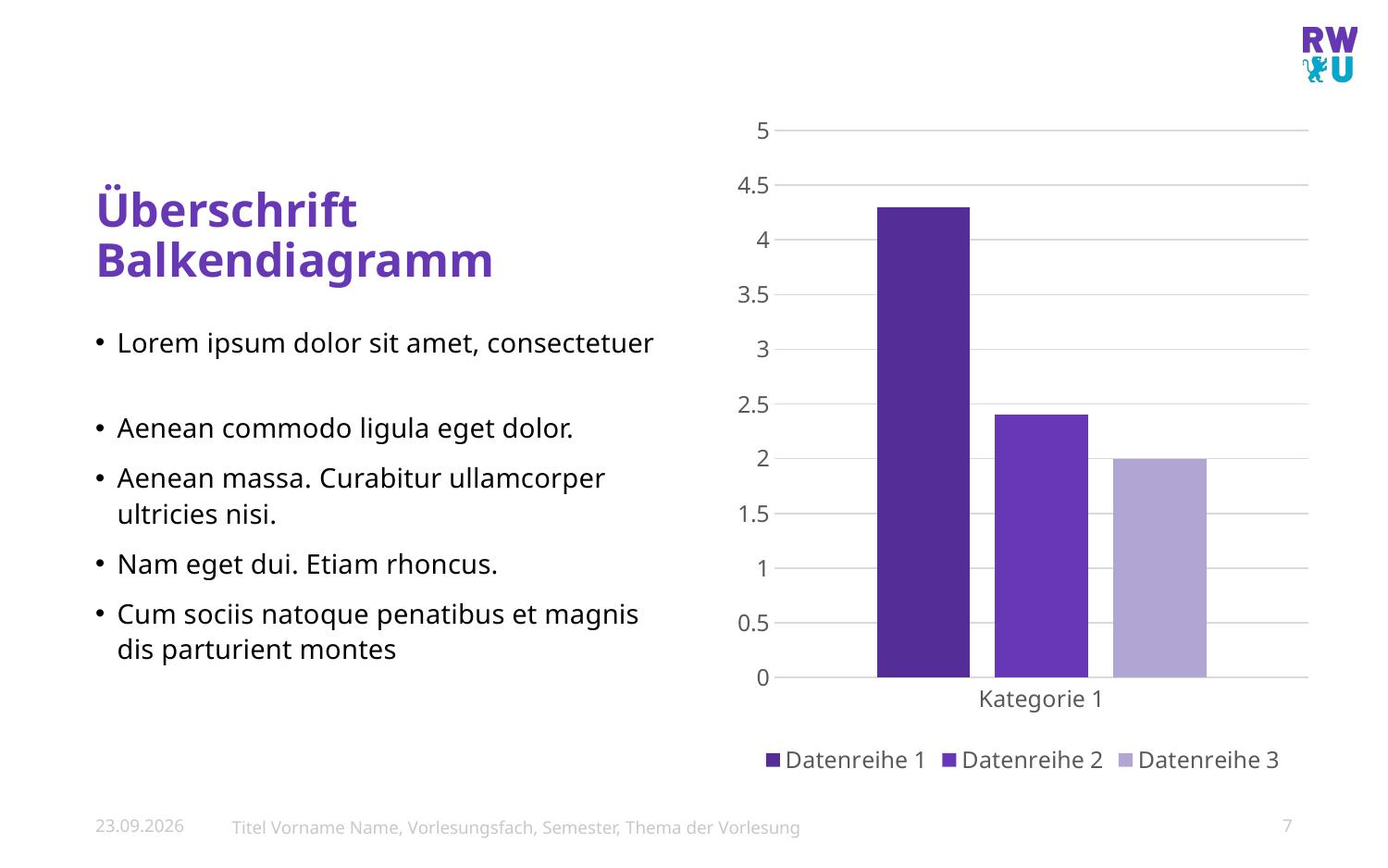
Is the value for Datenreihe 1 greater or less than 4? greater Which is larger, the value for Datenreihe 1 or the value for Datenreihe 2? Datenreihe 1 How many series does the chart legend list? 3 What is the highest value shown on the y axis of the chart? 5 Is the value for Datenreihe 2 greater or less than 2? greater Is the value for Datenreihe 1 greater or less than 4.5? less Which series has the lowest value for Kategorie 1? Datenreihe 3 How many categories are shown on the x axis of the chart? 1 Which series has the highest value for Kategorie 1? Datenreihe 1 What kind of chart is shown on the slide? bar chart What is the category label shown on the x axis? Kategorie 1